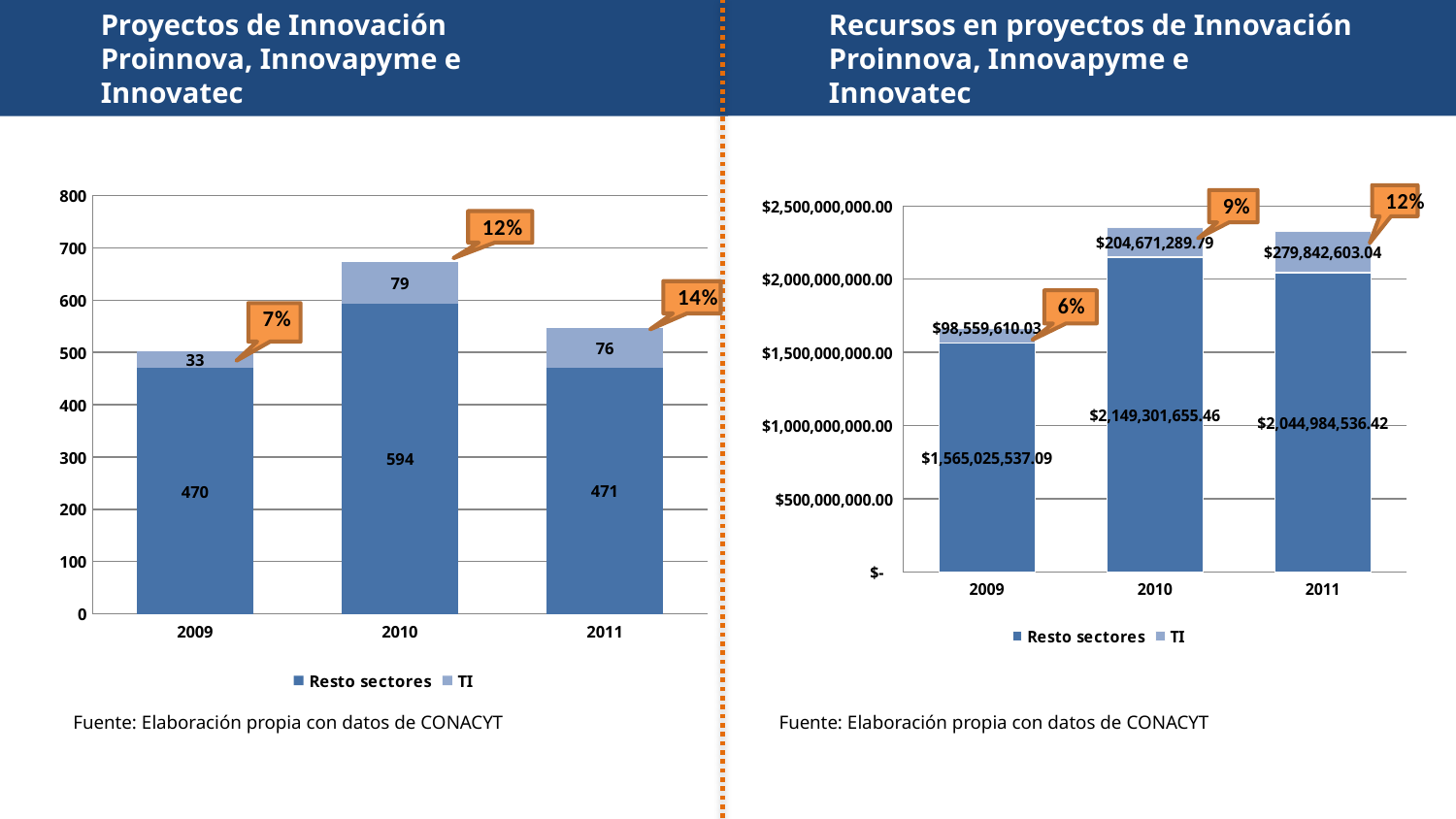
In the left chart (Proyectos de Innovación), what percentage is shown in the callout for 2011? 14% What kind of chart is the left chart (Proyectos de Innovación)? Stacked bar chart How many series does the legend of the right chart (Recursos en proyectos de Innovación) list? 2 In the right chart (Recursos en proyectos de Innovación), is the Resto sectores value for 2010 greater or less than $2,000,000,000.00? greater In the left chart (Proyectos de Innovación), what is the difference between the Resto sectores values for 2010 and 2009? 124 In the right chart (Recursos en proyectos de Innovación), what is the value for TI in 2011? $279,842,603.04 In the right chart (Recursos en proyectos de Innovación), what is the value for Resto sectores in 2009? $1,565,025,537.09 In the left chart (Proyectos de Innovación), what is the value for Resto sectores in 2010? 594 In the right chart (Recursos en proyectos de Innovación), which year has the lowest value for Resto sectores? 2009 In the left chart (Proyectos de Innovación), what is the value for TI in 2009? 33 In the left chart (Proyectos de Innovación), which year has the highest value for TI? 2010 In the left chart (Proyectos de Innovación), what is the total of the stacked bar for 2011? 547